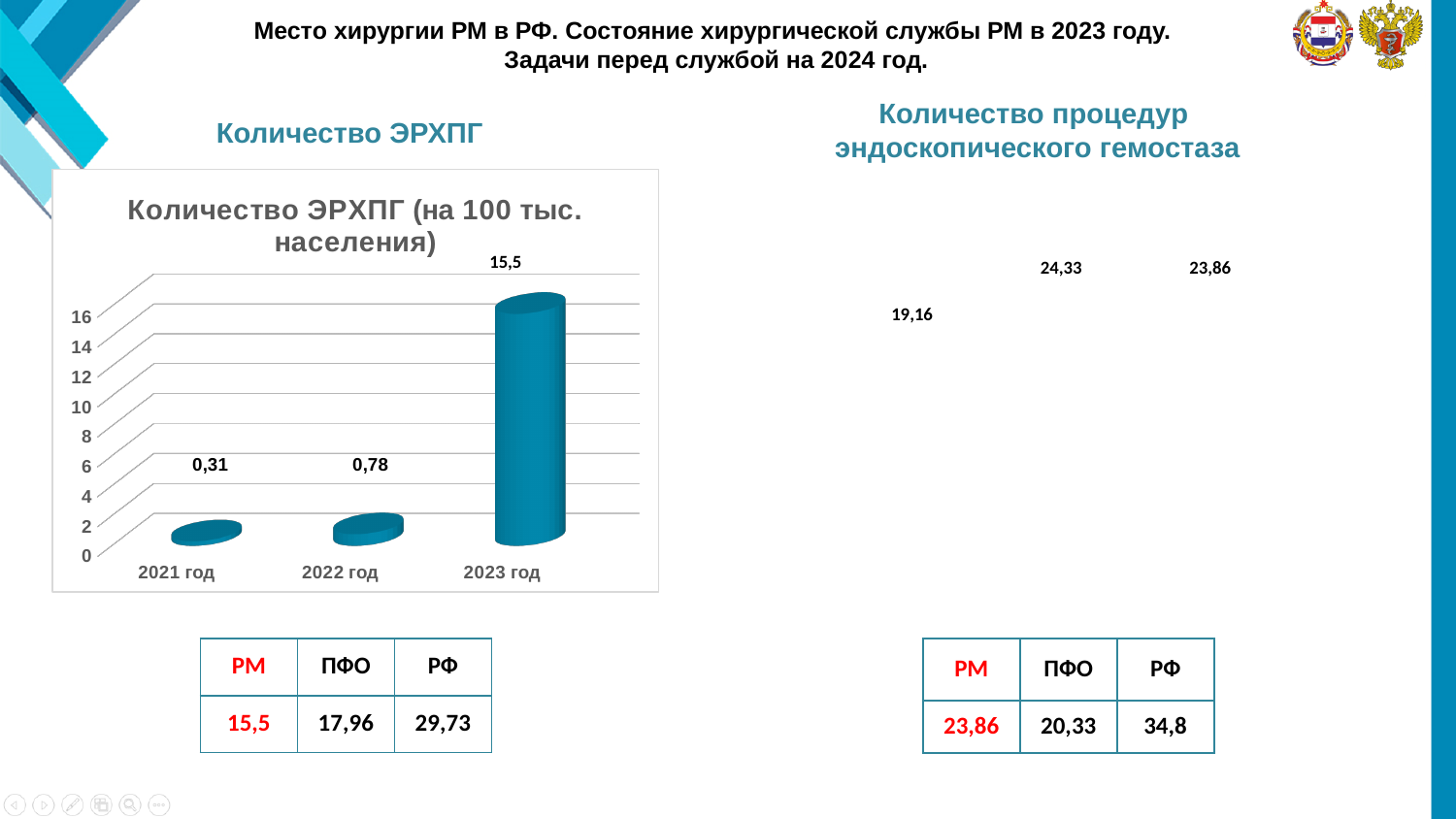
In the chart titled "Количество ЭРХПГ (на 100 тыс. населения)", do the values rise or fall from 2021 год to 2023 год? rise In the chart titled "Количество ЭРХПГ (на 100 тыс. населения)", which is larger: the value for 2021 год or 2022 год? 2022 год In the chart titled "Количество ЭРХПГ (на 100 тыс. населения)", what is the difference between the values for 2022 год and 2021 год? 0,47 What kind of chart is the one titled "Количество ЭРХПГ (на 100 тыс. населения)"? bar chart In the chart titled "Количество ЭРХПГ (на 100 тыс. населения)", what is the value for 2023 год? 15,5 How many years are shown on the x axis of the chart titled "Количество ЭРХПГ (на 100 тыс. населения)"? 3 In the chart titled "Количество ЭРХПГ (на 100 тыс. населения)", which year has the lowest value? 2021 год In the chart titled "Количество ЭРХПГ (на 100 тыс. населения)", what is the value for 2022 год? 0,78 In the chart titled "Количество ЭРХПГ (на 100 тыс. населения)", what is the difference between the values for 2023 год and 2022 год? 14,72 In the chart titled "Количество ЭРХПГ (на 100 тыс. населения)", what is the value for 2021 год? 0,31 In the chart titled "Количество ЭРХПГ (на 100 тыс. населения)", is the value for 2023 год greater or less than 14? greater In the chart titled "Количество ЭРХПГ (на 100 тыс. населения)", which year has the highest value? 2023 год